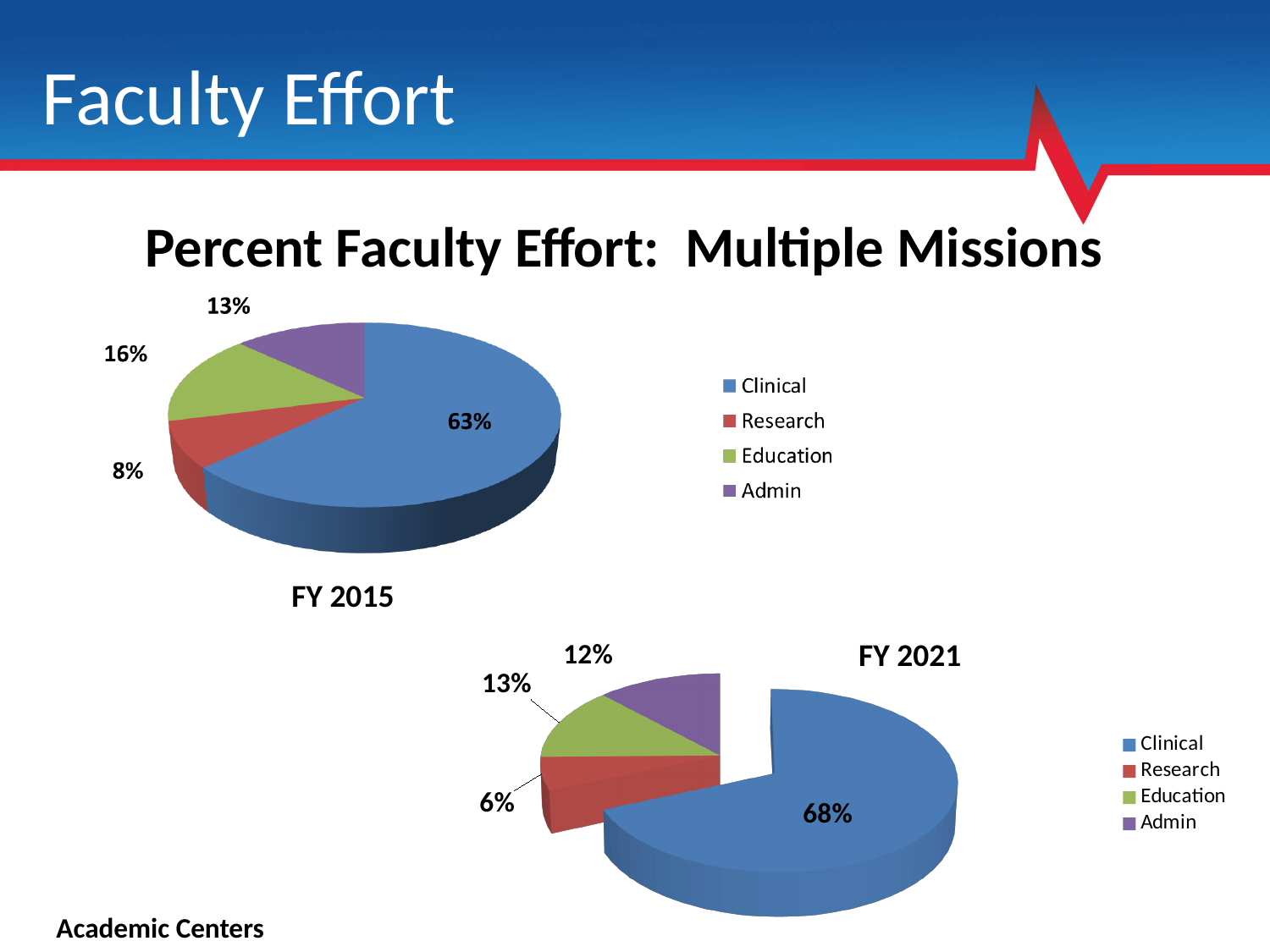
In the FY 2021 pie chart, which category has the largest share? Clinical In the FY 2021 pie chart, what is the share for Education? 13% In the FY 2015 pie chart, which category has the smallest share? Research In the FY 2015 pie chart, which is larger: Education or Admin? Education What is the difference between the Clinical share in FY 2021 and the Clinical share in FY 2015? 5% What type of chart is used for FY 2021? Pie chart In the FY 2021 pie chart, what percentage of faculty effort is Clinical? 68% What is the title shown above the two charts? Percent Faculty Effort: Multiple Missions In the FY 2021 pie chart, what is the share for Admin? 12% In the FY 2015 pie chart, what percentage of faculty effort is Clinical? 63% How many categories does the legend of the FY 2015 pie chart list? 4 In the FY 2015 pie chart, what is the share for Research? 8%